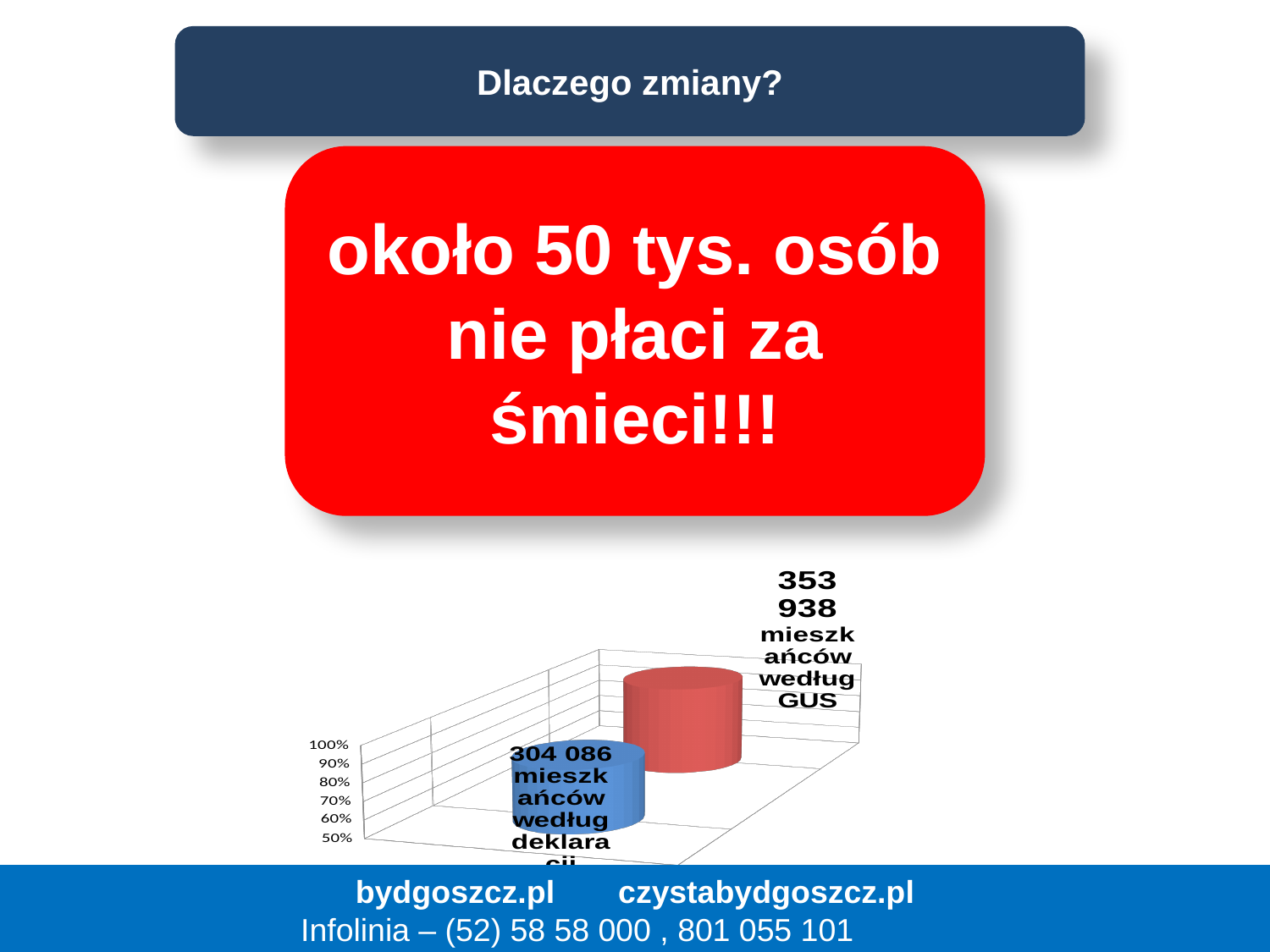
What is the difference between the number of residents according to GUS and the number according to declarations? 49 852 Which bar shows the larger number of residents? 353 938 mieszkańców według GUS Which bar shows the smaller number of residents? 304 086 mieszkańców według deklaracji How many bars does the chart show? 2 What number of residents is printed on the label of the red bar (według GUS)? 353 938 What colour is the bar for residents according to GUS? red Which bar is taller: the one for residents according to GUS or the one for residents according to declarations? according to GUS What is the lowest value shown on the chart's vertical axis? 50% What number of residents is printed on the label of the blue bar (według deklaracji)? 304 086 What kind of chart is shown at the bottom of the slide? bar chart